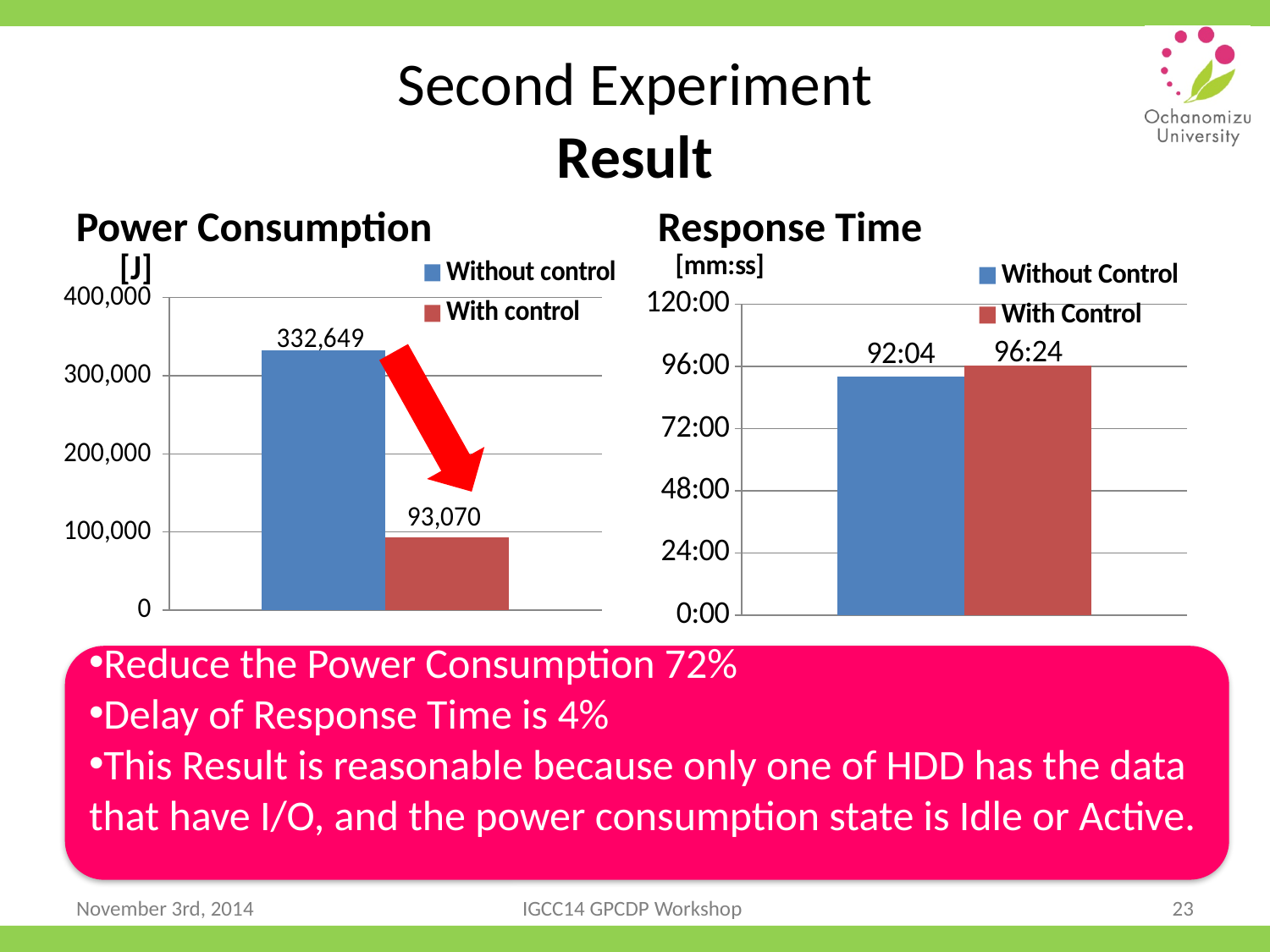
In the Power Consumption chart, which series has the higher value? Without control In the Response Time chart, what is the value for Without Control? 92:04 In the Power Consumption chart, what is the difference between the Without control and With control values? 239,579 In the Response Time chart, what is the value for With Control? 96:24 In the Response Time chart, is the value for With Control greater or less than 96:00? greater How many series does the legend of the Response Time chart list? 2 What unit is shown on the axis of the Response Time chart? [mm:ss] In the Power Consumption chart, is the value for With control greater or less than 100,000? less In the Power Consumption chart, what is the value for With control? 93,070 In the Response Time chart, which series has the lower value? Without Control What kind of chart is the Power Consumption chart? bar chart In the Power Consumption chart, what is the value for Without control? 332,649